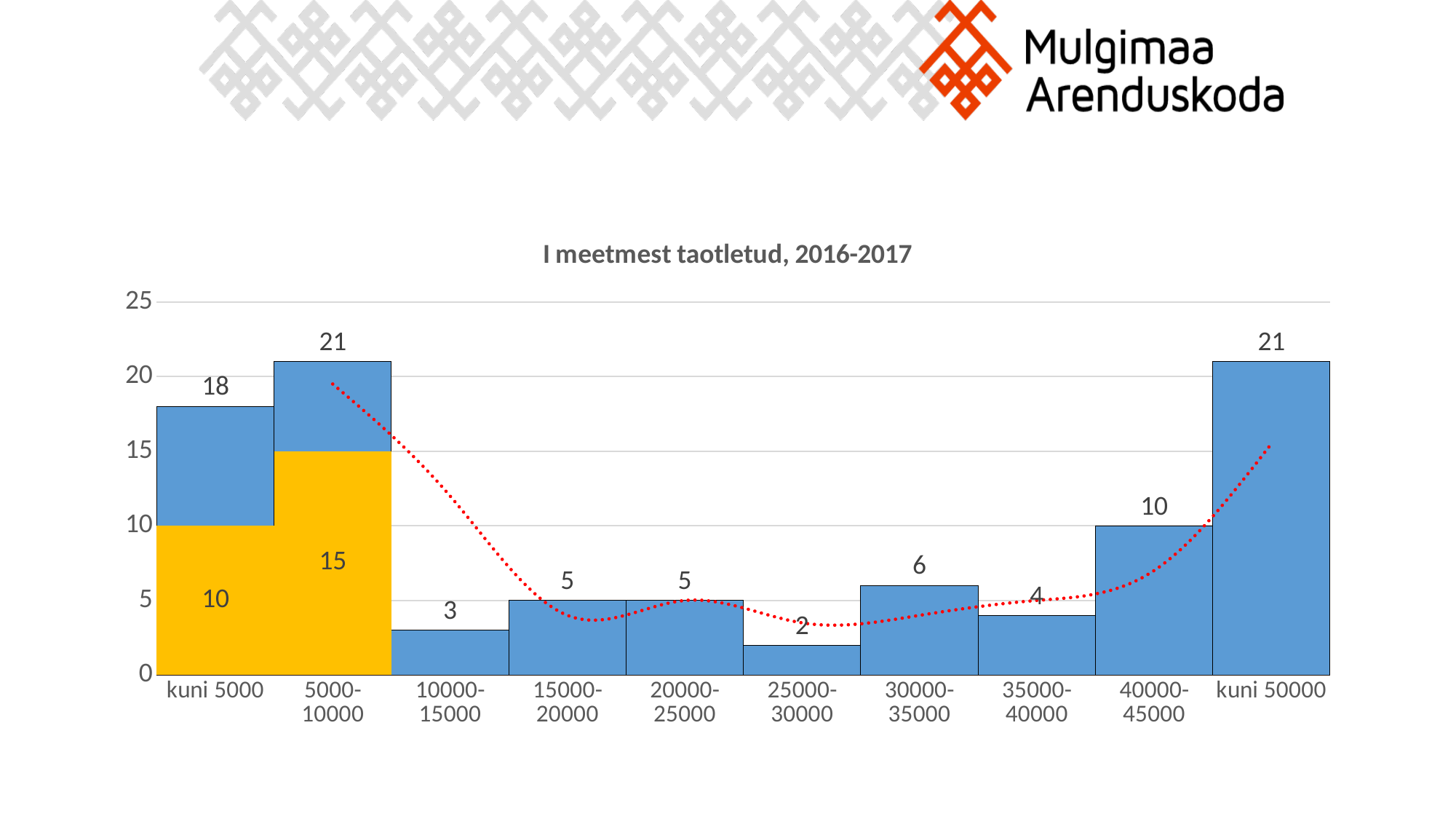
What value is labelled on the yellow bar in the kuni 5000 category? 10 What is the value for the 30000-35000 category? 6 What is the highest value shown on any bar in the chart? 21 What is the difference between the values for 5000-10000 and 10000-15000? 18 What kind of chart is shown on the slide? bar chart What is the difference between the values for kuni 5000 and 25000-30000? 16 What is the value for the 10000-15000 category? 3 Which has the larger value, 30000-35000 or 35000-40000? 30000-35000 How many categories are shown on the x axis? 10 Which category has the lowest value? 25000-30000 What is the title of the chart? I meetmest taotletud, 2016-2017 What is the value for the 40000-45000 category? 10